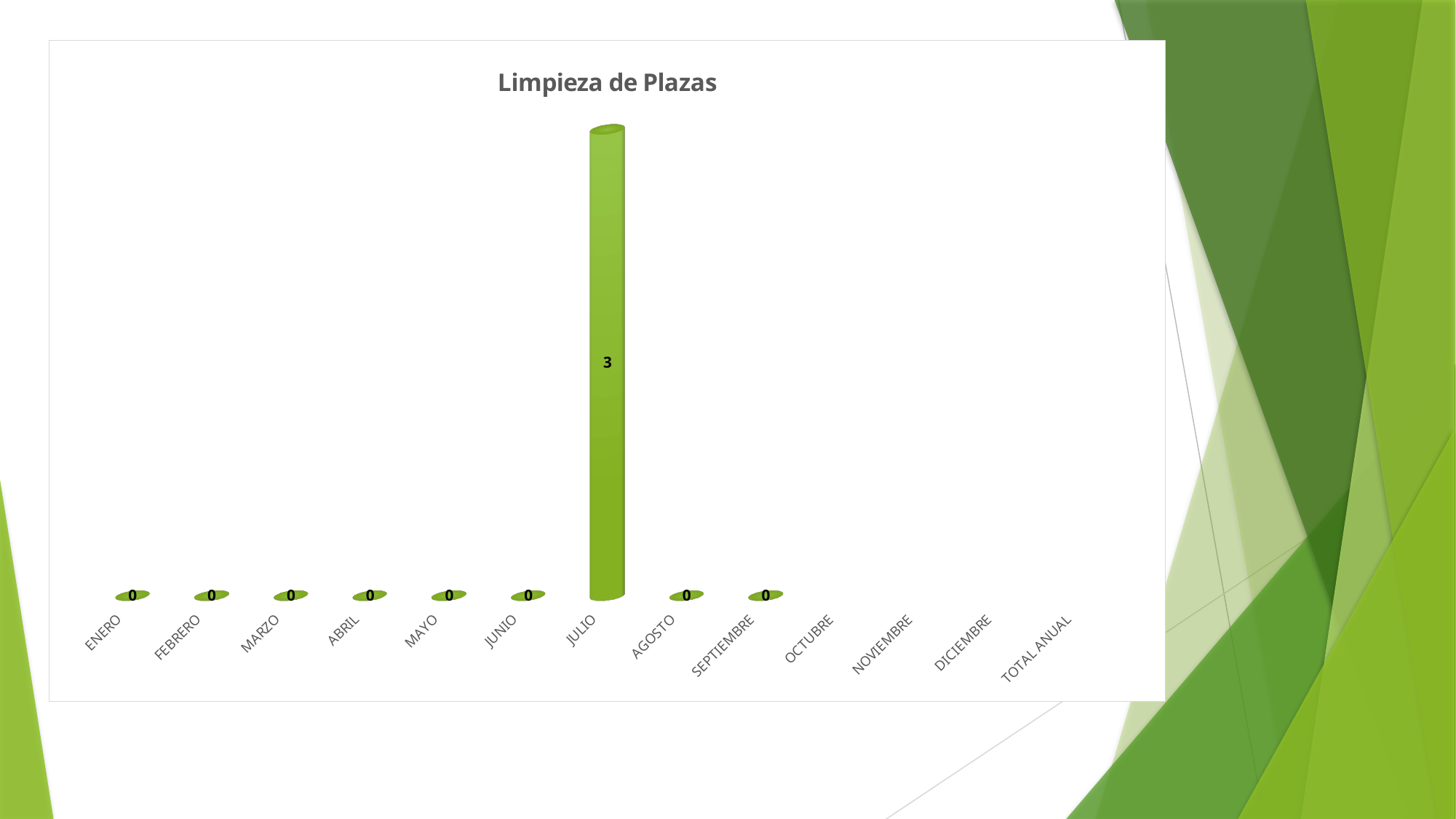
What is the value for JULIO? 3 What is the value for SEPTIEMBRE? 0 What colour are the bars in the chart? green What is the value for ENERO? 0 How many bars have a data label printed on the chart? 9 What is the difference between the values for JULIO and AGOSTO? 3 What is the value for ABRIL? 0 How many category labels are shown on the x axis? 13 Which month has the highest value? JULIO What kind of chart is shown on the slide? bar chart Which is larger, the value for JULIO or the value for MARZO? JULIO What is the title of the chart? Limpieza de Plazas